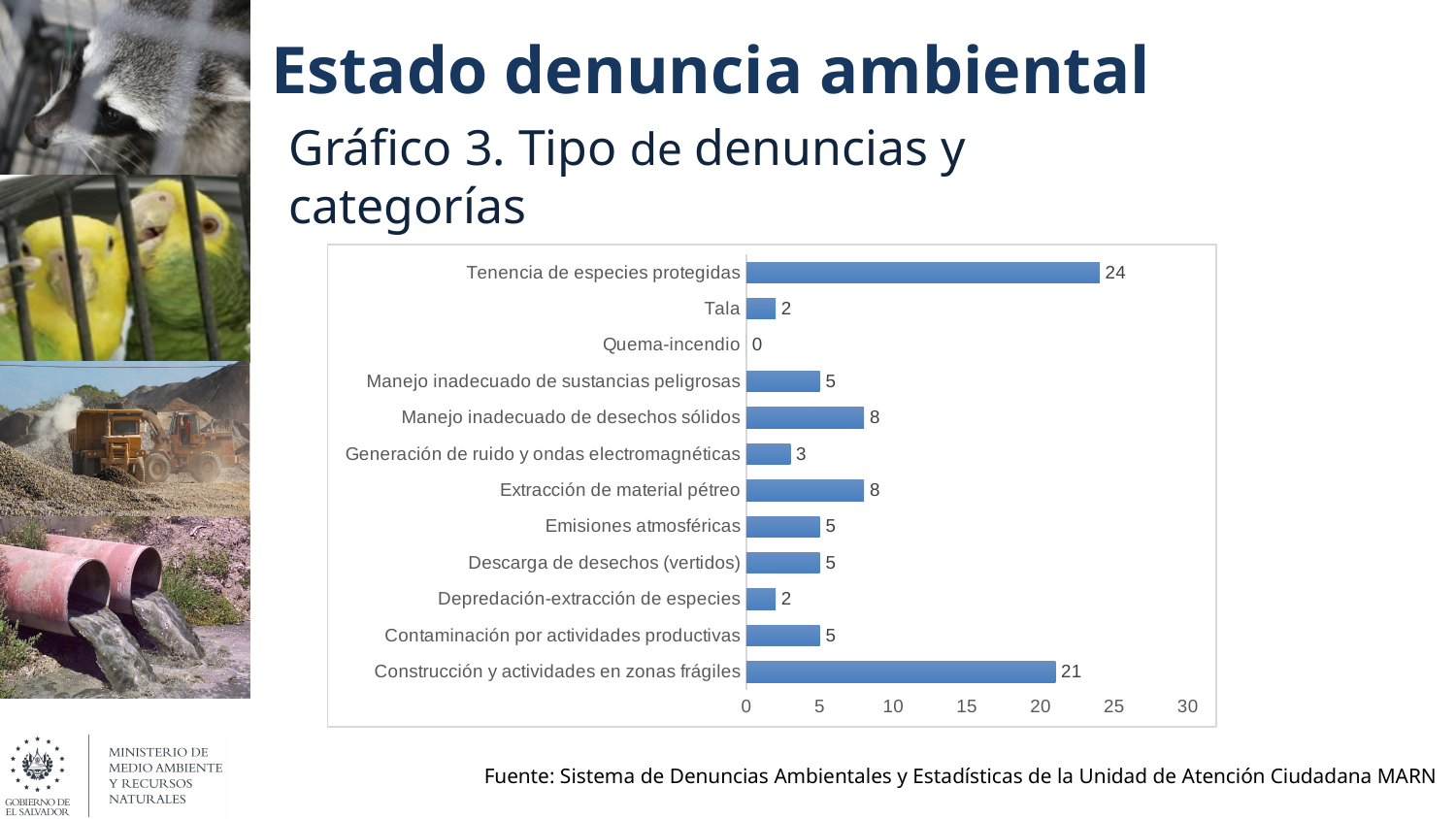
Is the value for Construcción y actividades en zonas frágiles greater or less than 20? greater Which is larger, Manejo inadecuado de desechos sólidos or Manejo inadecuado de sustancias peligrosas? Manejo inadecuado de desechos sólidos What is the value for Construcción y actividades en zonas frágiles? 21 Which category has the lowest value? Quema-incendio What is the value for Tenencia de especies protegidas? 24 How many categories are shown in the chart? 12 Which category has the highest value? Tenencia de especies protegidas What is the difference between Tenencia de especies protegidas and Construcción y actividades en zonas frágiles? 3 What is the value for Generación de ruido y ondas electromagnéticas? 3 What is the title of the chart? Gráfico 3. Tipo de denuncias y categorías What kind of chart is shown on the slide? Bar chart What is the value for Quema-incendio? 0